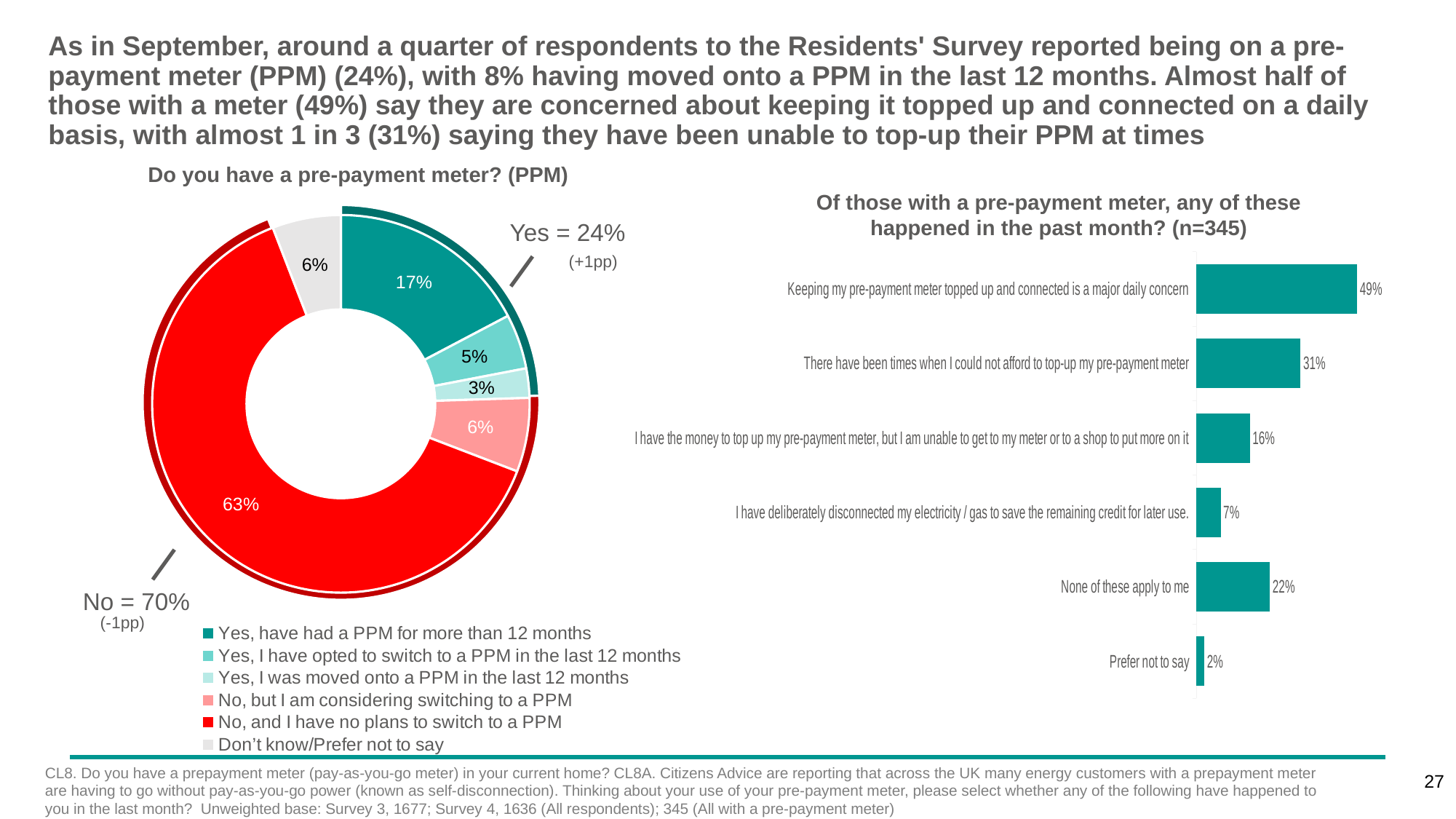
In the 'Of those with a pre-payment meter' chart, which is larger: 'None of these apply to me' or 'I have the money to top up my pre-payment meter, but I am unable to get to my meter or to a shop to put more on it'? None of these apply to me In the 'Do you have a pre-payment meter? (PPM)' chart, which category has the smallest share? Yes, I was moved onto a PPM in the last 12 months In the 'Of those with a pre-payment meter' chart, what percentage said keeping their pre-payment meter topped up and connected is a major daily concern? 49% In the 'Of those with a pre-payment meter' chart, what is the difference between the percentage who could not afford to top-up and the percentage who have the money but are unable to get to their meter or a shop? 15% In the 'Do you have a pre-payment meter? (PPM)' chart, how many categories does the legend list? 6 What kind of chart is the 'Of those with a pre-payment meter' chart? Bar chart In the 'Do you have a pre-payment meter? (PPM)' chart, what share of respondents said 'No, and I have no plans to switch to a PPM'? 63% What kind of chart is the 'Do you have a pre-payment meter? (PPM)' chart? Pie (doughnut) chart In the 'Do you have a pre-payment meter? (PPM)' chart, which category has the largest share? No, and I have no plans to switch to a PPM In the 'Of those with a pre-payment meter' chart, what percentage said they have deliberately disconnected their electricity / gas to save the remaining credit for later use? 7% In the 'Of those with a pre-payment meter' chart, which statement has the lowest percentage? Prefer not to say In the 'Do you have a pre-payment meter? (PPM)' chart, what share of respondents said 'Yes, have had a PPM for more than 12 months'? 17%